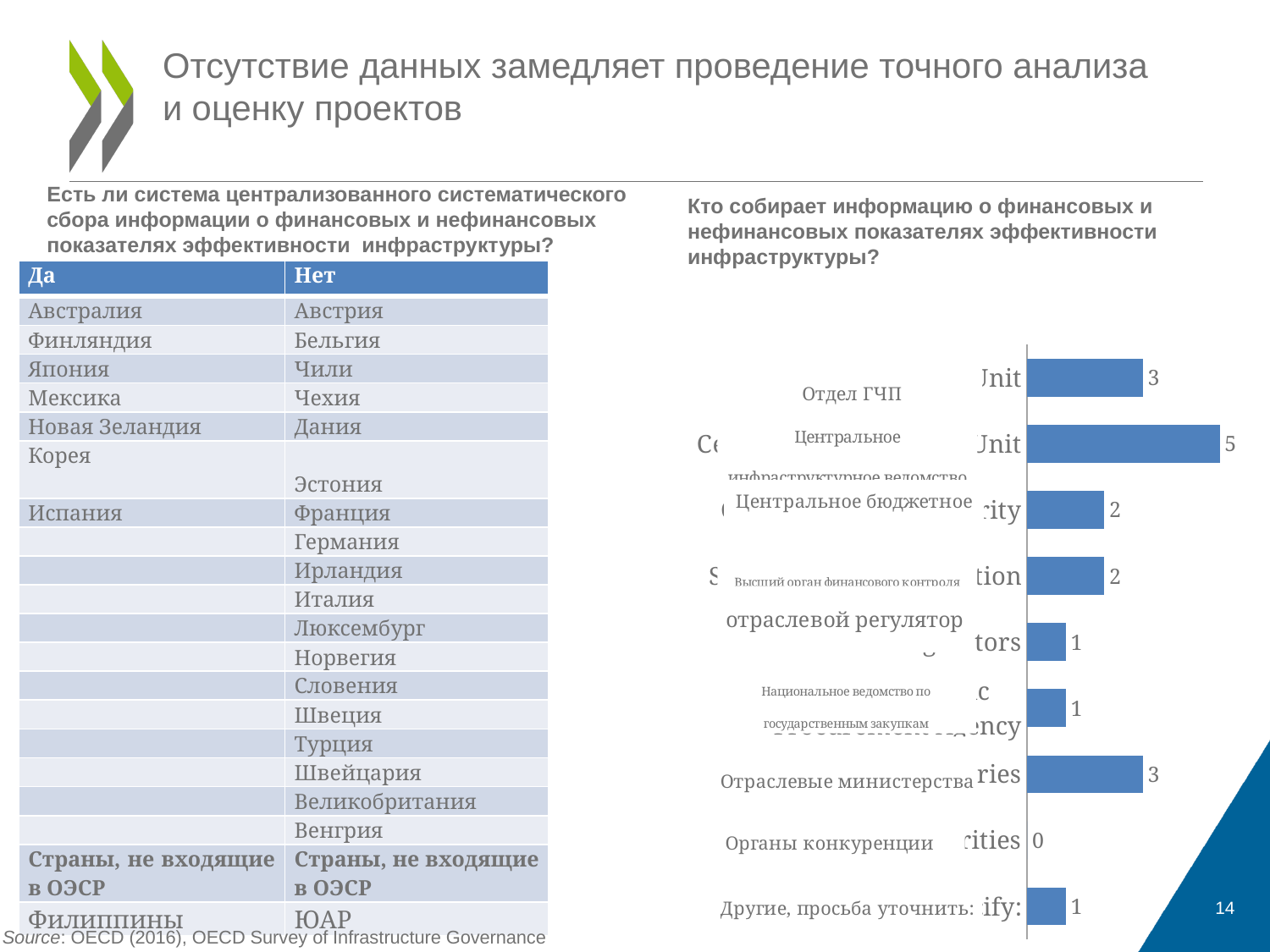
In the bar chart, what is the value for Отдел ГЧП? 3 In the bar chart, what is the value for Высший орган финансового контроля? 2 In the bar chart, what is the value for Центральное инфраструктурное ведомство? 5 In the bar chart, what is the difference between the values for Центральное инфраструктурное ведомство and Отдел ГЧП? 2 Which category has the highest value in the bar chart? Центральное инфраструктурное ведомство Which category has the lowest value in the bar chart? Органы конкуренции In the bar chart, what is the value for Отраслевые министерства? 3 What kind of chart is shown on the right side of the slide? bar chart In the bar chart, what is the value for Органы конкуренции? 0 In the bar chart, which is larger: the value for Отдел ГЧП or the value for Центральное бюджетное? Отдел ГЧП How many categories are shown in the bar chart? 9 In the bar chart, what is the value for Другие, просьба уточнить? 1